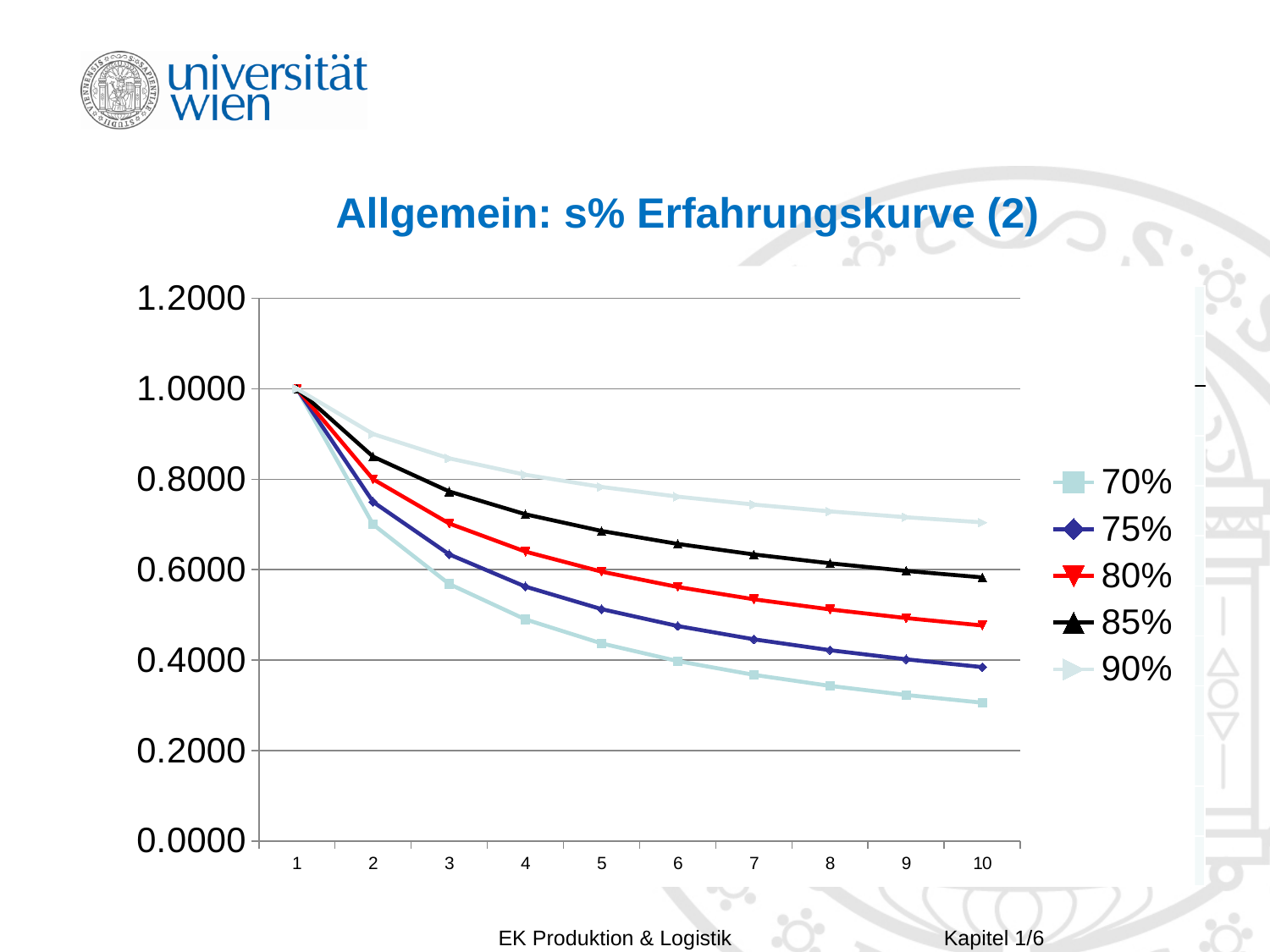
Is the value of the 90% series at x = 10 greater or less than 0.6000? greater How many series does the legend list? 5 Do the values of the 70% series rise or fall as x increases from 1 to 10? fall Is the value of the 85% series at x = 2 greater or less than 0.8000? greater What kind of chart is shown on the slide? line chart At x = 5, which series has the larger value, 80% or 75%? 80% Is the value of the 70% series at x = 10 greater or less than 0.4000? less Which series has the highest value at x = 10? 90% How many points are plotted along the x axis for each series? 10 What is the title of the chart slide? Allgemein: s% Erfahrungskurve (2) Which colour is used for the 80% series? red Which series has the lowest value at x = 10? 70%